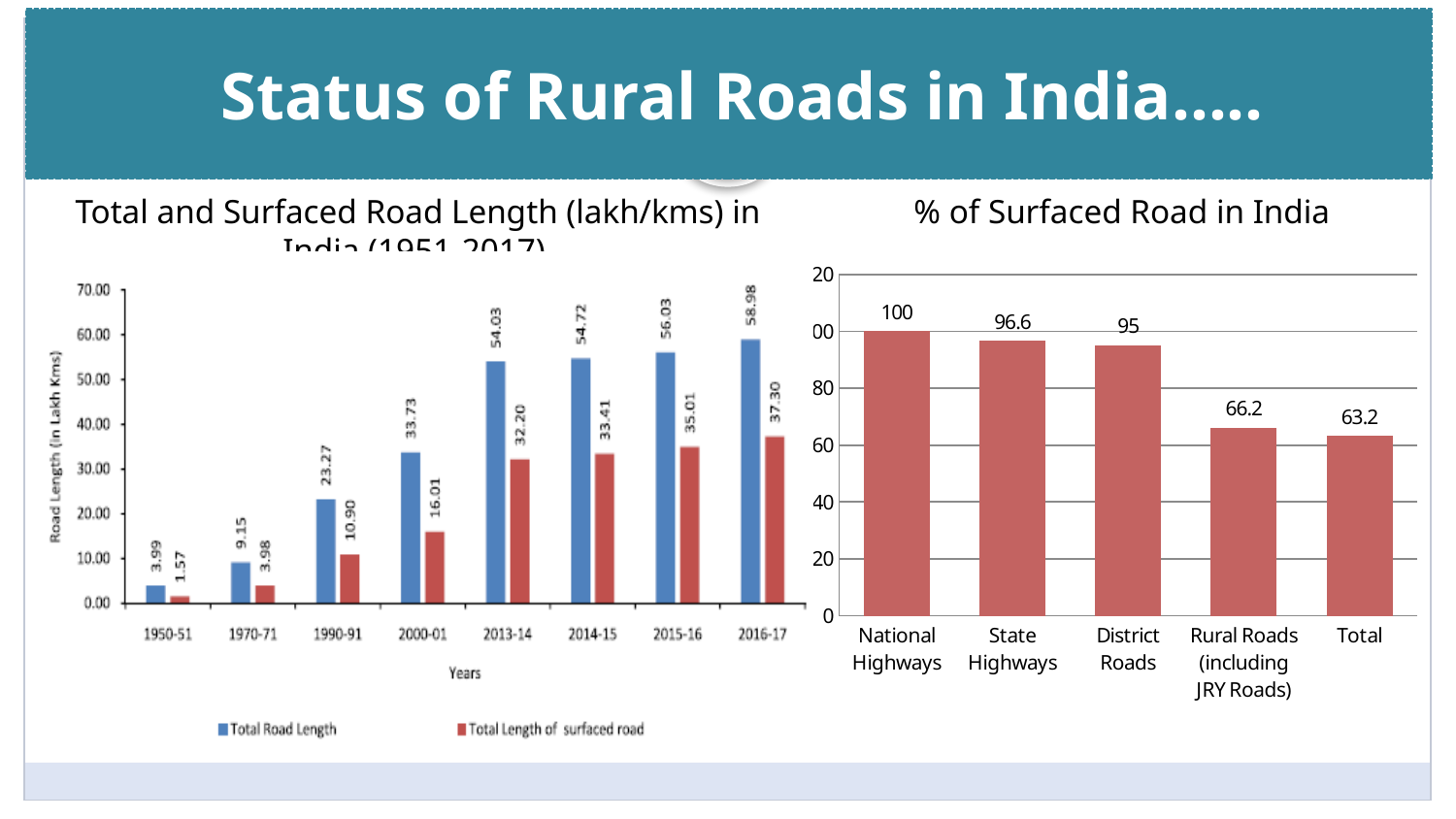
In the right chart (% of Surfaced Road in India), which category has the highest value? National Highways In the left chart (Total and Surfaced Road Length), what is the Total Length of surfaced road for 1990-91? 10.90 In the right chart (% of Surfaced Road in India), which category has the lowest value? Total In the left chart (Total and Surfaced Road Length), how many years are shown on the x axis? 8 In the right chart (% of Surfaced Road in India), what is the value for District Roads? 95 In the left chart (Total and Surfaced Road Length), which year has the lowest Total Road Length? 1950-51 In the left chart (Total and Surfaced Road Length), how many series does the legend list? 2 In the right chart (% of Surfaced Road in India), what is the difference between State Highways and Rural Roads (including JRY Roads)? 30.4 In the left chart (Total and Surfaced Road Length), does the Total Road Length rise or fall from 1950-51 to 2016-17? rise In the left chart (Total and Surfaced Road Length), what is the Total Road Length for 2016-17? 58.98 What kind of chart is the right chart (% of Surfaced Road in India)? bar chart In the left chart (Total and Surfaced Road Length), what is the difference between Total Road Length and Total Length of surfaced road in 2000-01? 17.72